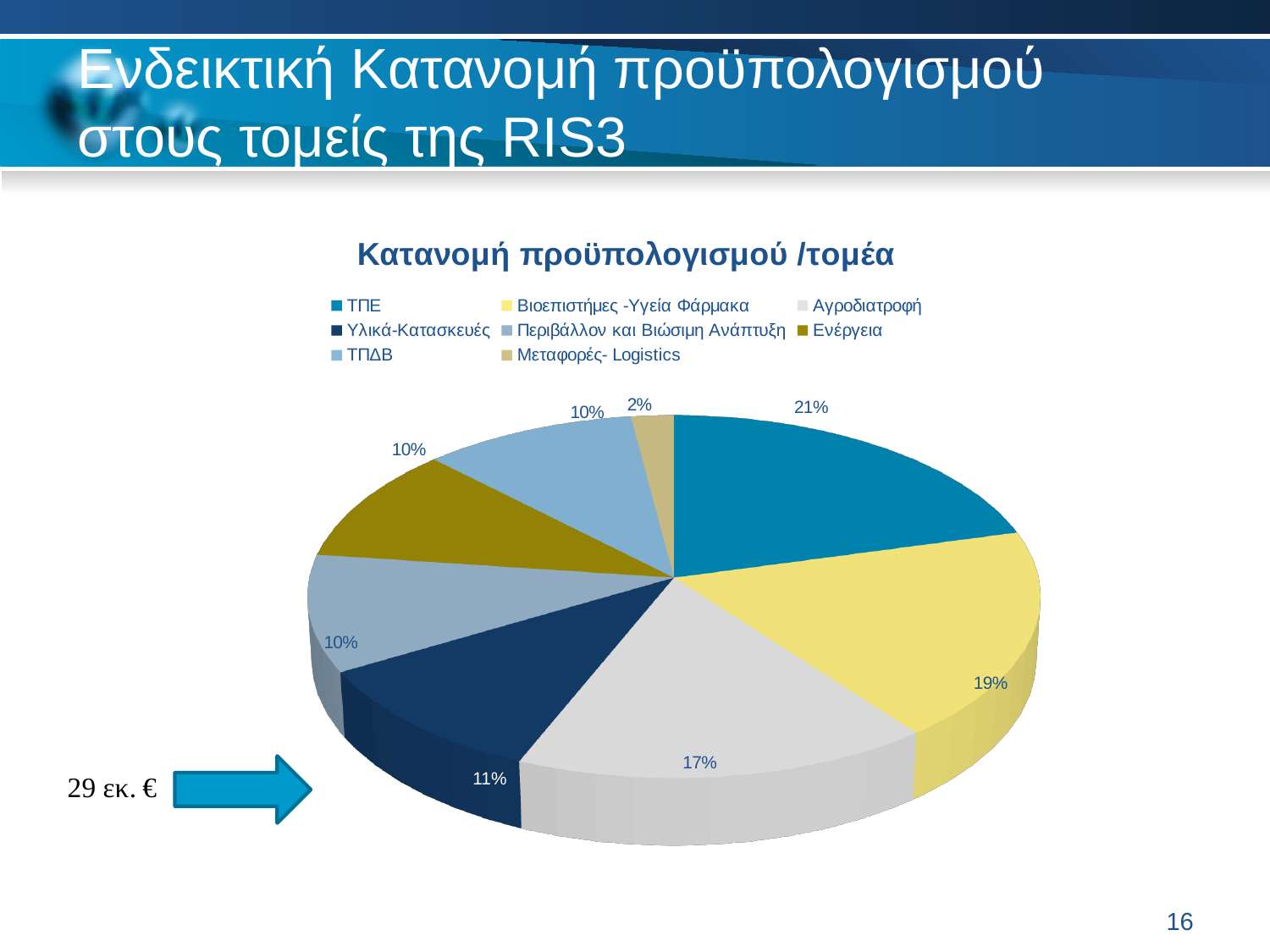
Which sector has the smallest share of the budget? Μεταφορές- Logistics Which has a larger share, Βιοεπιστήμες -Υγεία Φάρμακα or Υλικά-Κατασκευές? Βιοεπιστήμες -Υγεία Φάρμακα What kind of chart is shown on the slide? pie chart What share of the budget goes to Βιοεπιστήμες -Υγεία Φάρμακα? 19% What is the difference in percentage points between the ΤΠΕ share and the Αγροδιατροφή share? 4 percentage points What is the title of the chart? Κατανομή προϋπολογισμού /τομέα What share of the budget goes to Υλικά-Κατασκευές? 11% What share of the budget goes to ΤΠΕ? 21% Which sector has the largest share of the budget? ΤΠΕ What share of the budget goes to Αγροδιατροφή? 17% How many entries does the legend list? 8 How many slices does the pie chart have? 8